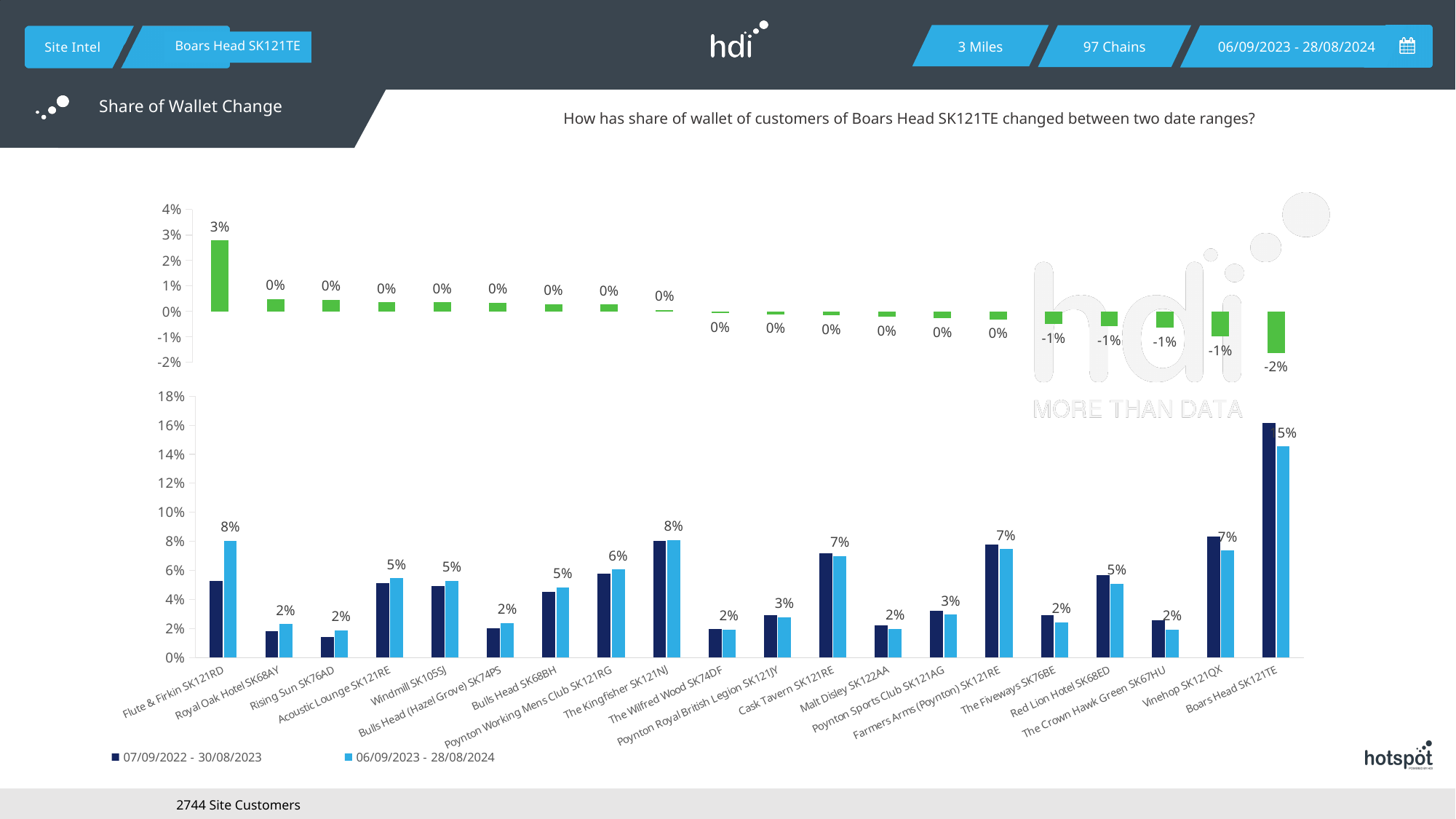
In the top chart (share of wallet change), what is the value for Boars Head SK121TE? -2% In the top chart (share of wallet change), what is the value for Flute & Firkin SK121RD? 3% In the bottom chart, for the 06/09/2023 - 28/08/2024 series, which is larger: Flute & Firkin SK121RD or Royal Oak Hotel SK68AY? Flute & Firkin SK121RD In the bottom chart, what is the value for Cask Tavern SK121RE in the 06/09/2023 - 28/08/2024 series? 7% In the bottom chart, what is the value for The Kingfisher SK121NJ in the 06/09/2023 - 28/08/2024 series? 8% In the top chart (share of wallet change), which category has the lowest value? Boars Head SK121TE In the bottom chart, is the value for Boars Head SK121TE in the 07/09/2022 - 30/08/2023 series greater or less than 14%? greater In the top chart (share of wallet change), what is the value for Vinehop SK121QX? -1% In the top chart (share of wallet change), which category has the highest value? Flute & Firkin SK121RD What kind of chart is the bottom chart on the slide? Bar chart How many categories are shown on the x axis of the bottom chart? 20 How many series does the legend of the bottom chart list? 2